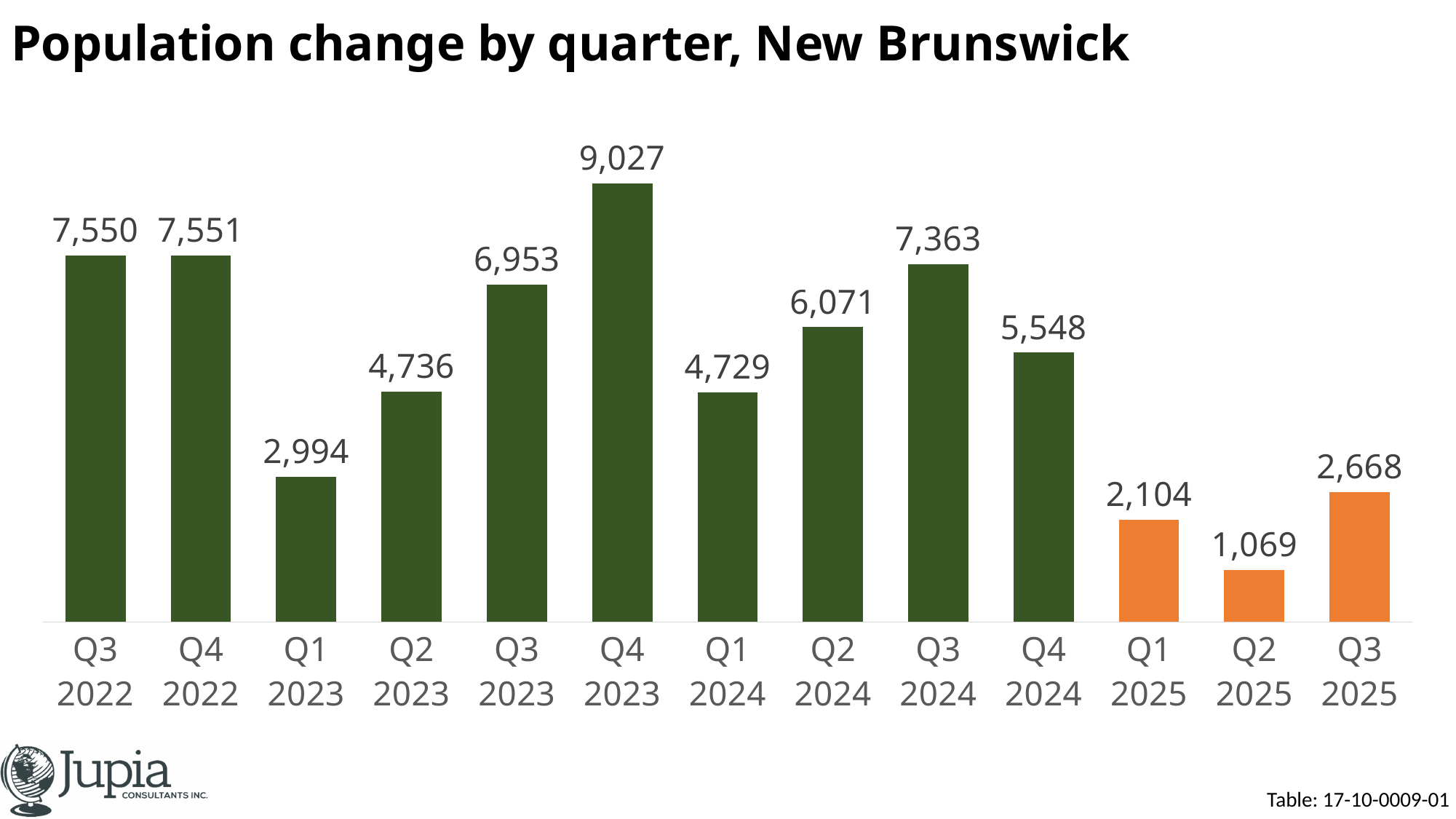
Which is larger, the population change in Q3 2024 or Q4 2024? Q3 2024 What is the difference between the population change in Q3 2025 and Q2 2025? 1,599 Which quarter has the highest population change? Q4 2023 How many quarters are shown in the chart? 13 What is the population change for Q2 2025? 1,069 What is the population change for Q1 2023? 2,994 What is the population change for Q4 2023? 9,027 What is the title of the chart? Population change by quarter, New Brunswick Which is larger, the population change in Q2 2023 or Q1 2024? Q2 2023 What kind of chart is shown on the slide? Bar chart Which quarter has the lowest population change? Q2 2025 What is the difference between the population change in Q4 2023 and Q3 2024? 1,664